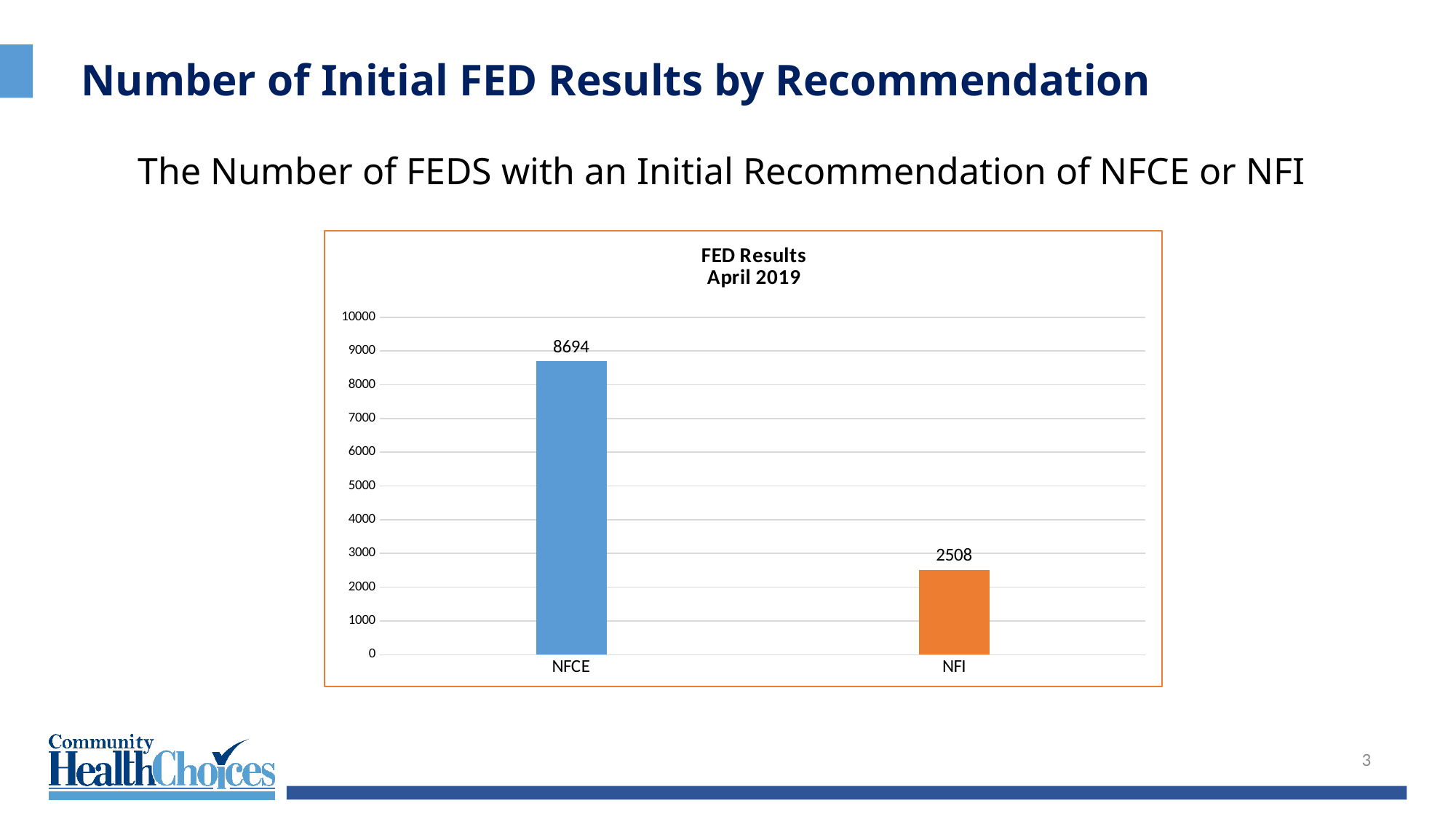
What is the value for NFCE? 8694 How many categories are shown on the chart? 2 What kind of chart is shown on the slide? bar chart What is the difference between the values for NFCE and NFI? 6186 What is the value for NFI? 2508 What is the title of the chart? FED Results April 2019 What colour is the bar for NFI? orange Which is larger, the value for NFCE or the value for NFI? NFCE Which category has the lowest value? NFI Which category has the highest value? NFCE Is the value for NFI greater or less than 3000? less Is the value for NFCE greater or less than 8000? greater